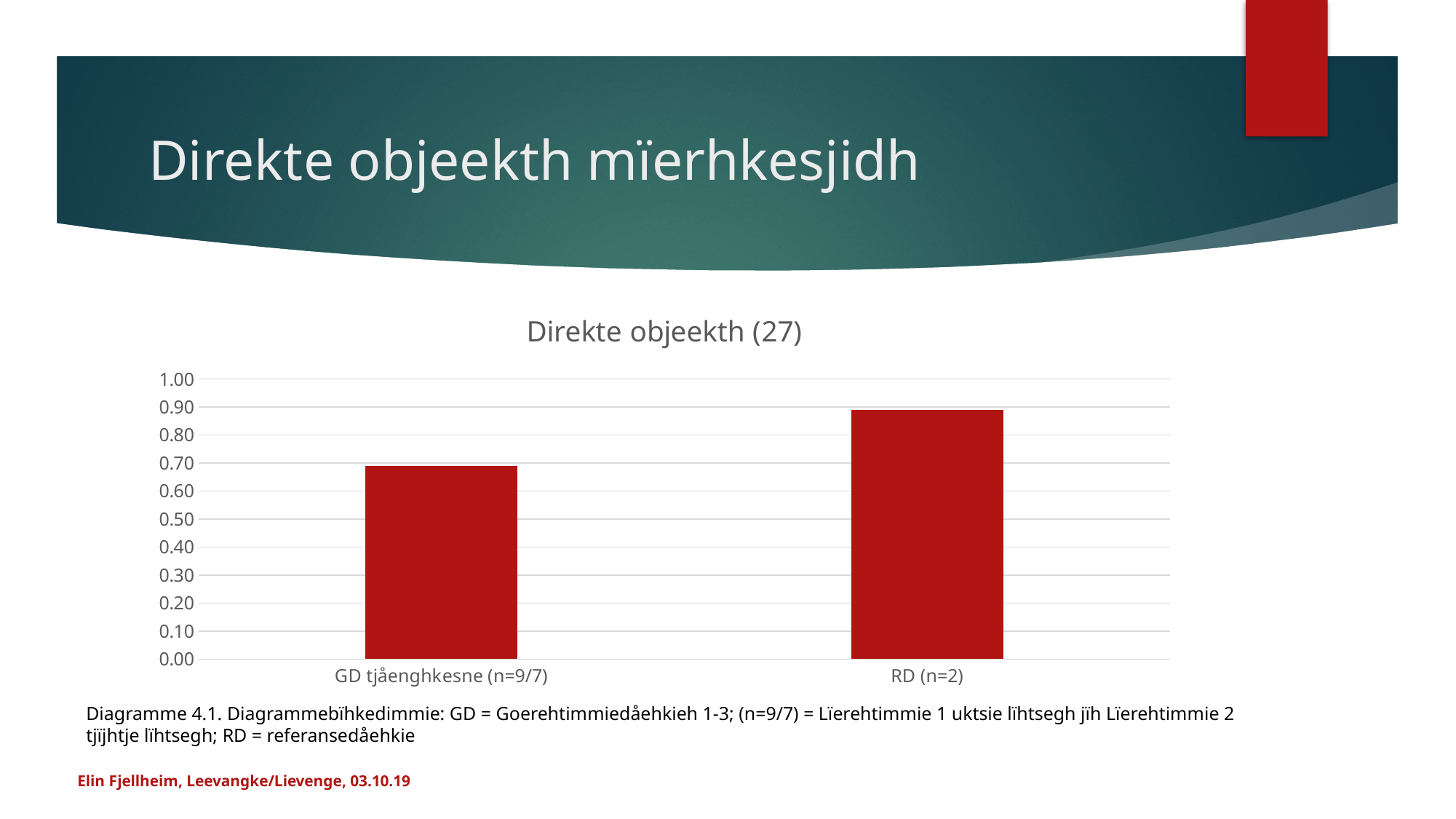
Is the value for GD tjåenghkesne (n=9/7) greater or less than 0.80? less How many categories are shown on the x axis of the chart? 2 Which is larger, the value for GD tjåenghkesne (n=9/7) or the value for RD (n=2)? RD (n=2) What is the highest tick value shown on the y axis of the chart? 1.00 What is the title of the chart? Direkte objeekth (27) Is the value for GD tjåenghkesne (n=9/7) greater or less than 0.60? greater What kind of chart is shown on the slide? bar chart Is the value for RD (n=2) greater or less than 1.00? less Do the values rise or fall from left to right along the x axis? rise Which category has the lowest value in the chart? GD tjåenghkesne (n=9/7) Which category has the highest value in the chart? RD (n=2)